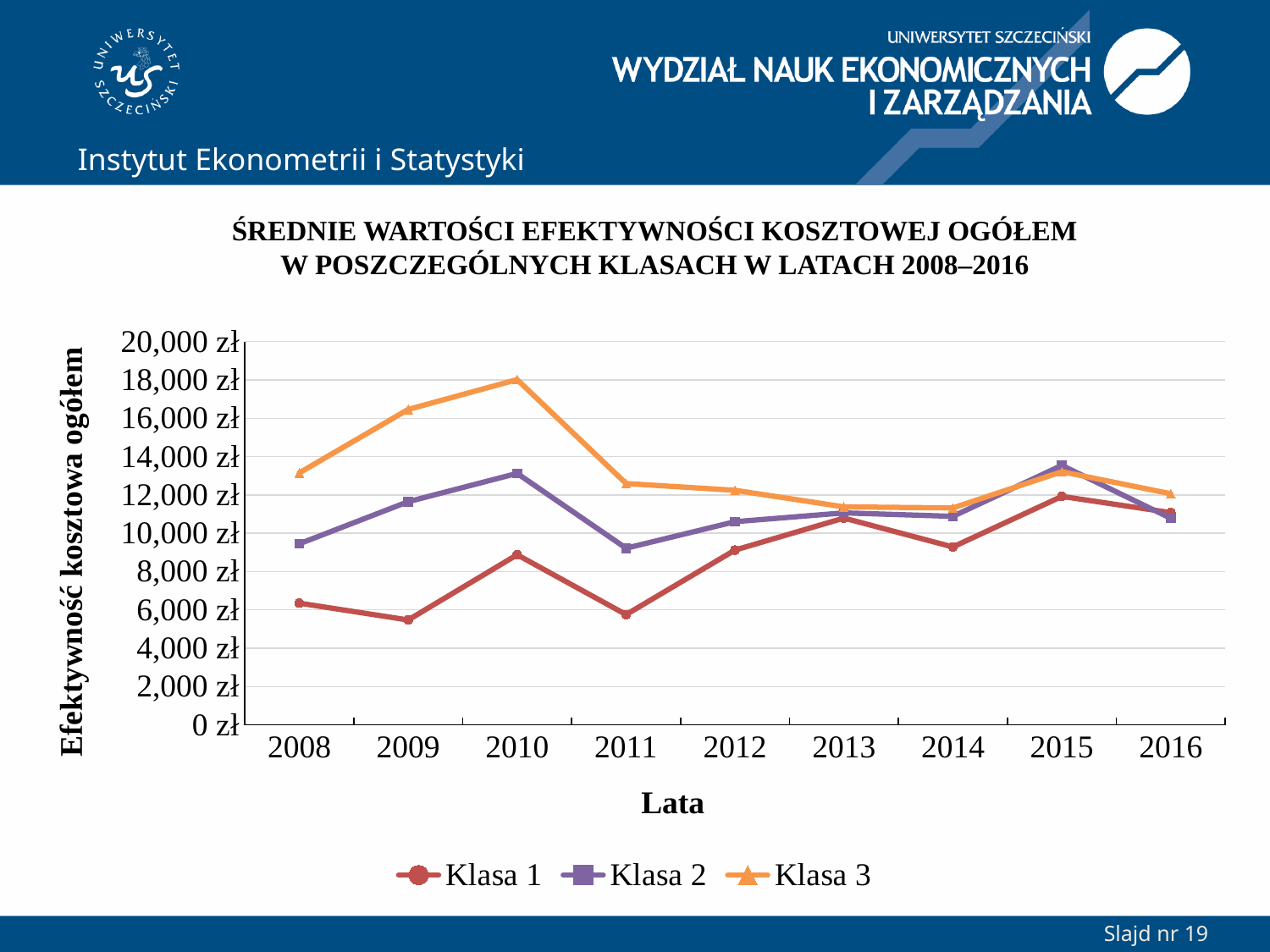
Is the value for Klasa 2 in 2008 greater or less than 10,000 zł? less How many series does the legend list? 3 Is the value for Klasa 1 in 2009 greater or less than 6,000 zł? less What is the title of the x axis? Lata In 2010, which series has the larger value, Klasa 1 or Klasa 2? Klasa 2 Is the value for Klasa 3 in 2010 greater or less than 16,000 zł? greater In 2008, which series has the larger value, Klasa 1 or Klasa 3? Klasa 3 What kind of chart is shown on the slide? line chart In which year does Klasa 3 reach its highest value? 2010 Does the value for Klasa 3 rise or fall from 2010 to 2011? fall How many years are plotted along the x axis? 9